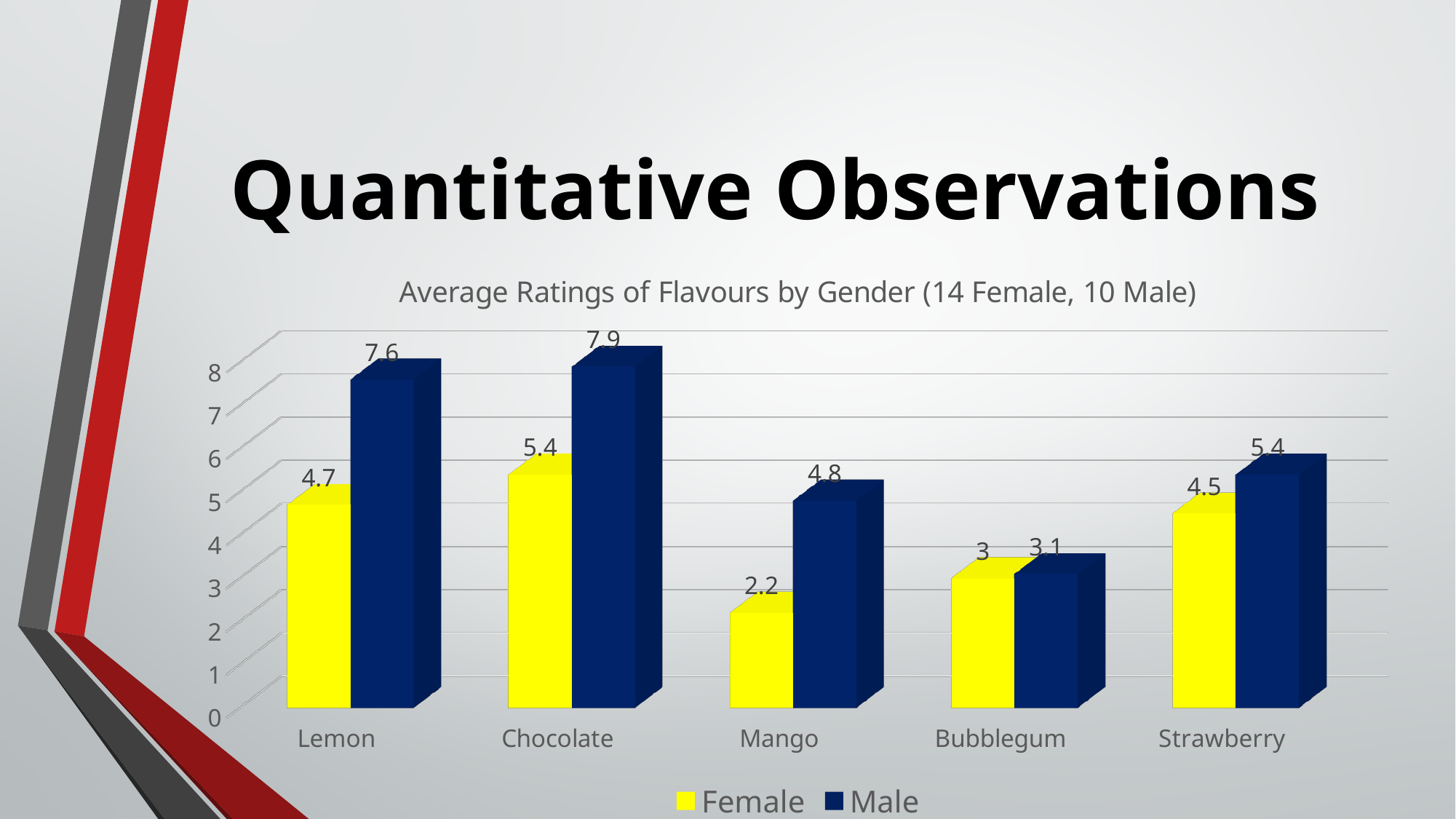
How many series does the legend list? 2 What is the title of the chart? Average Ratings of Flavours by Gender (14 Female, 10 Male) Which is larger for Mango: the Female rating or the Male rating? Male What is the Female average rating for Mango? 2.2 What kind of chart is shown on the slide? Bar chart Which flavour has the highest Male average rating? Chocolate What is the difference between the Male and Female average ratings for Lemon? 2.9 What is the Male average rating for Strawberry? 5.4 Which flavour has the lowest Female average rating? Mango How many flavours are shown on the x axis? 5 What is the Male average rating for Chocolate? 7.9 What is the Female average rating for Lemon? 4.7